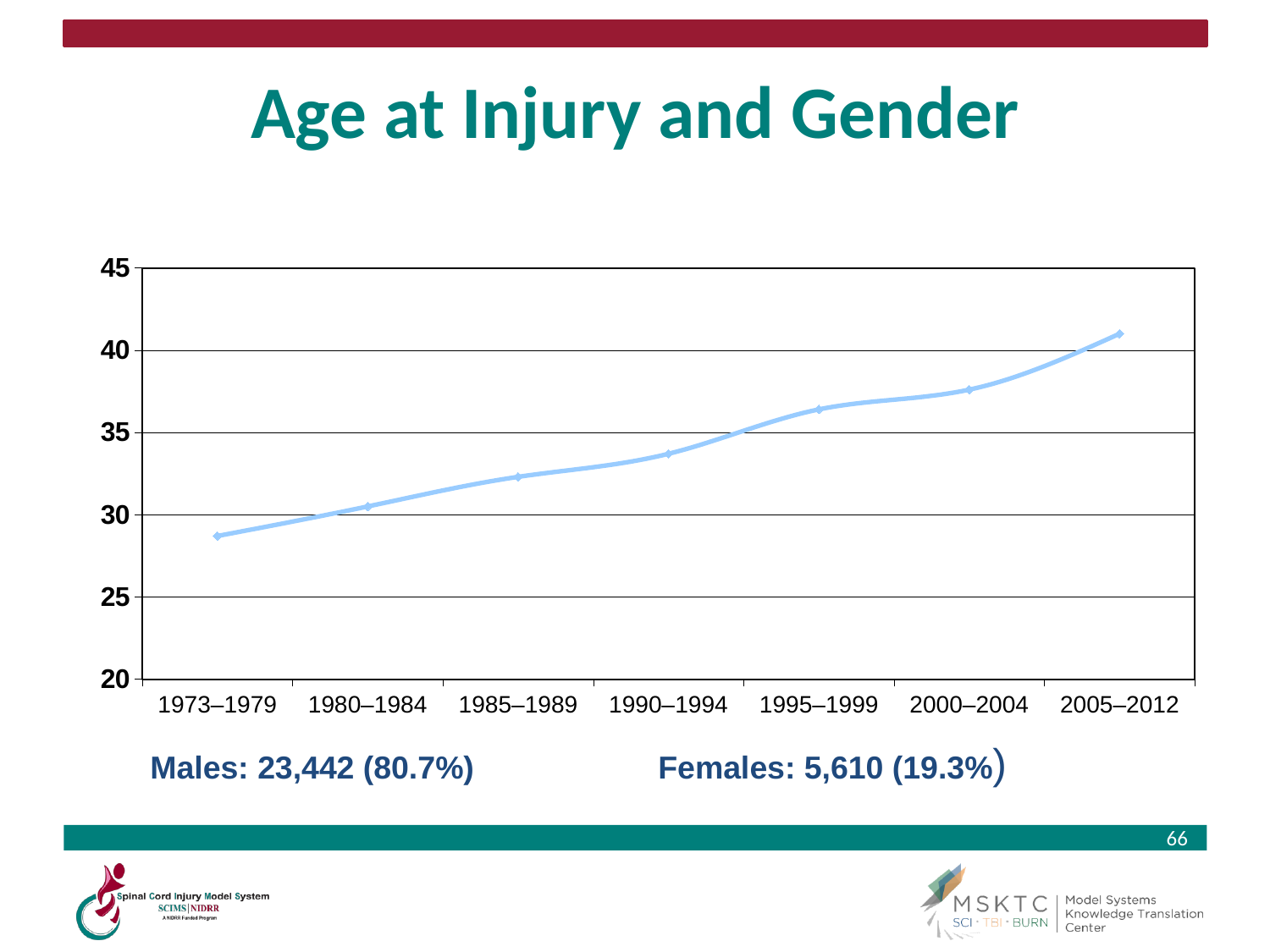
Is the value for 1995–1999 greater or less than 35? greater Which time period has the highest value? 2005–2012 How many time periods are plotted along the x axis? 7 Is the value for 1973–1979 greater or less than 30? less What is the title of the slide containing the chart? Age at Injury and Gender Is the value for 2005–2012 greater or less than 40? greater What kind of chart is shown on the slide? line chart Do the values rise or fall from 1973–1979 to 2005–2012? rise Which time period has the lowest value? 1973–1979 Which is larger, the value for 2005–2012 or the value for 1973–1979? 2005–2012